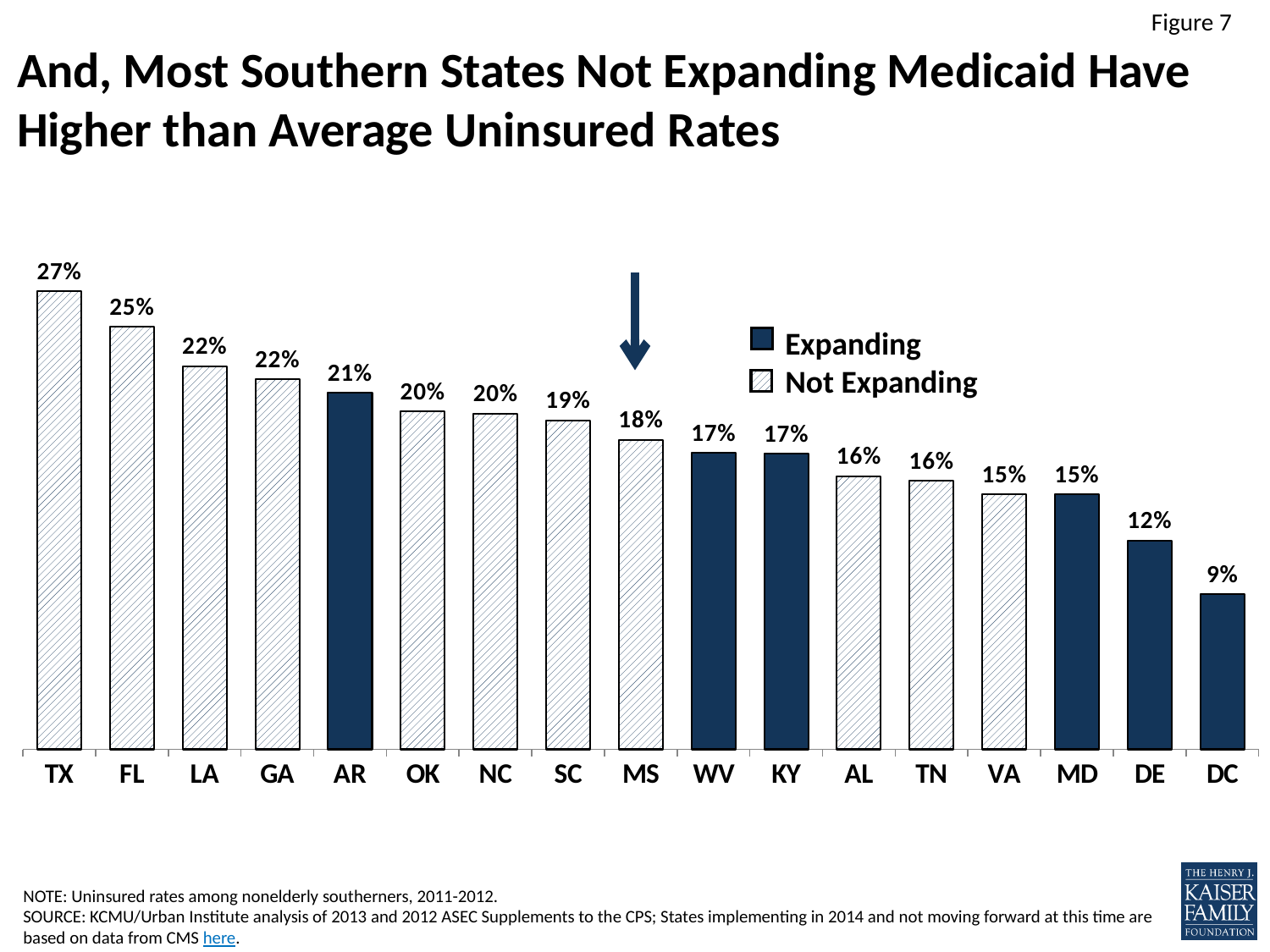
What is the difference between the uninsured rates for FL and MS? 7% How many states are shown on the chart? 17 Which has a higher uninsured rate, GA or VA? GA What is the uninsured rate shown for DE? 12% Which state has the lowest uninsured rate on the chart? DC How many series does the legend list? 2 What is the uninsured rate shown for AR? 21% What is the uninsured rate shown for TX? 27% What is the difference between the uninsured rates for TX and DC? 18% What kind of chart is shown on the slide? Bar chart Which state has the highest uninsured rate on the chart? TX Do the uninsured rates rise or fall from left to right across the chart? Fall